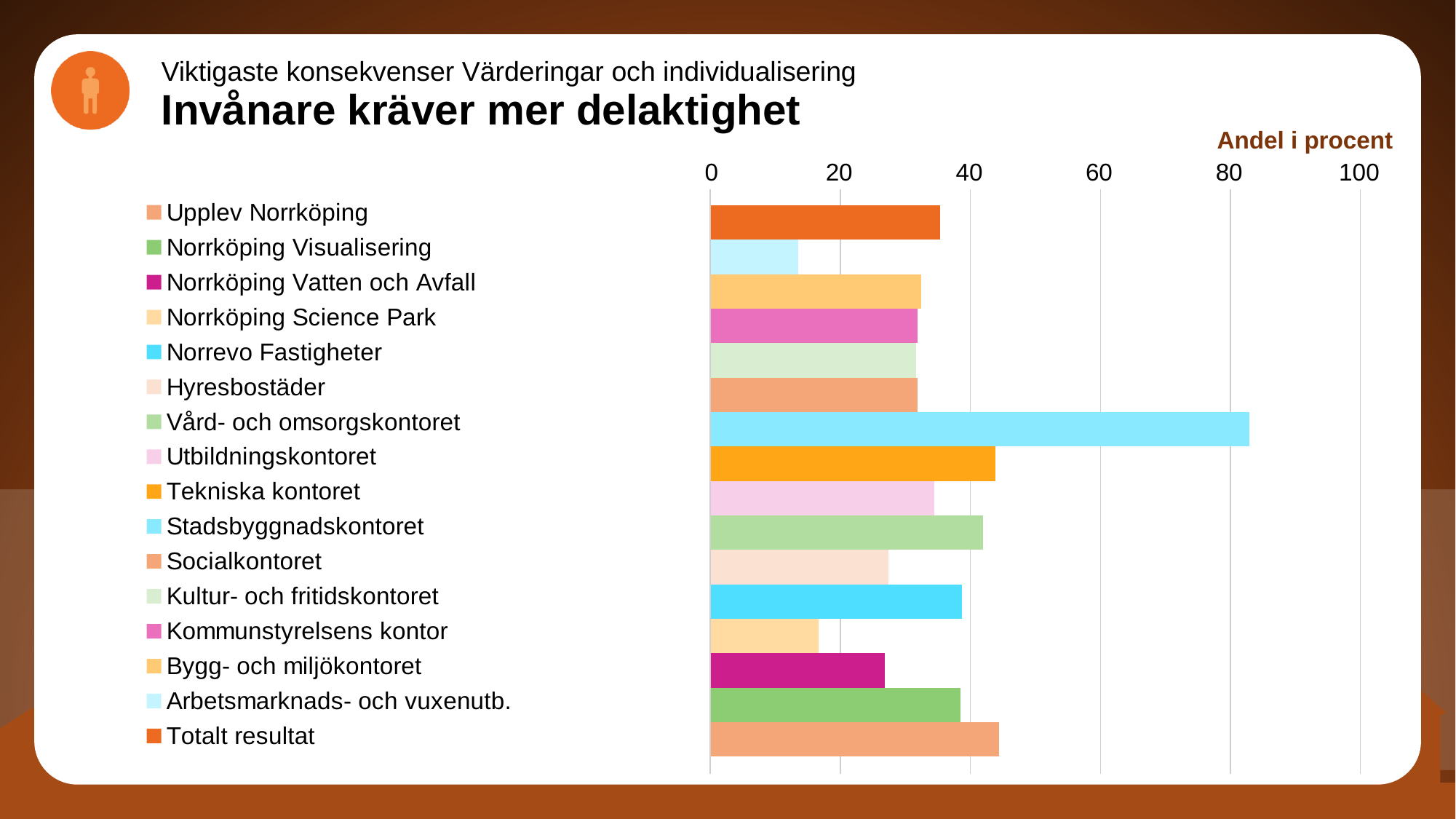
How many categories are plotted in the chart? 16 Is the value for Totalt resultat greater or less than 40? less Is the value for Hyresbostäder greater or less than 20? greater Which is larger, the value for Norrköping Visualisering or the value for Norrköping Vatten och Avfall? Norrköping Visualisering Is the value for Tekniska kontoret greater or less than 40? greater What kind of chart is shown on the slide? bar chart What is the axis title shown above the chart's value axis? Andel i procent Which category has the lowest value in the chart? Arbetsmarknads- och vuxenutb. Which is larger, the value for Stadsbyggnadskontoret or the value for Totalt resultat? Stadsbyggnadskontoret Which category has the highest value in the chart? Stadsbyggnadskontoret